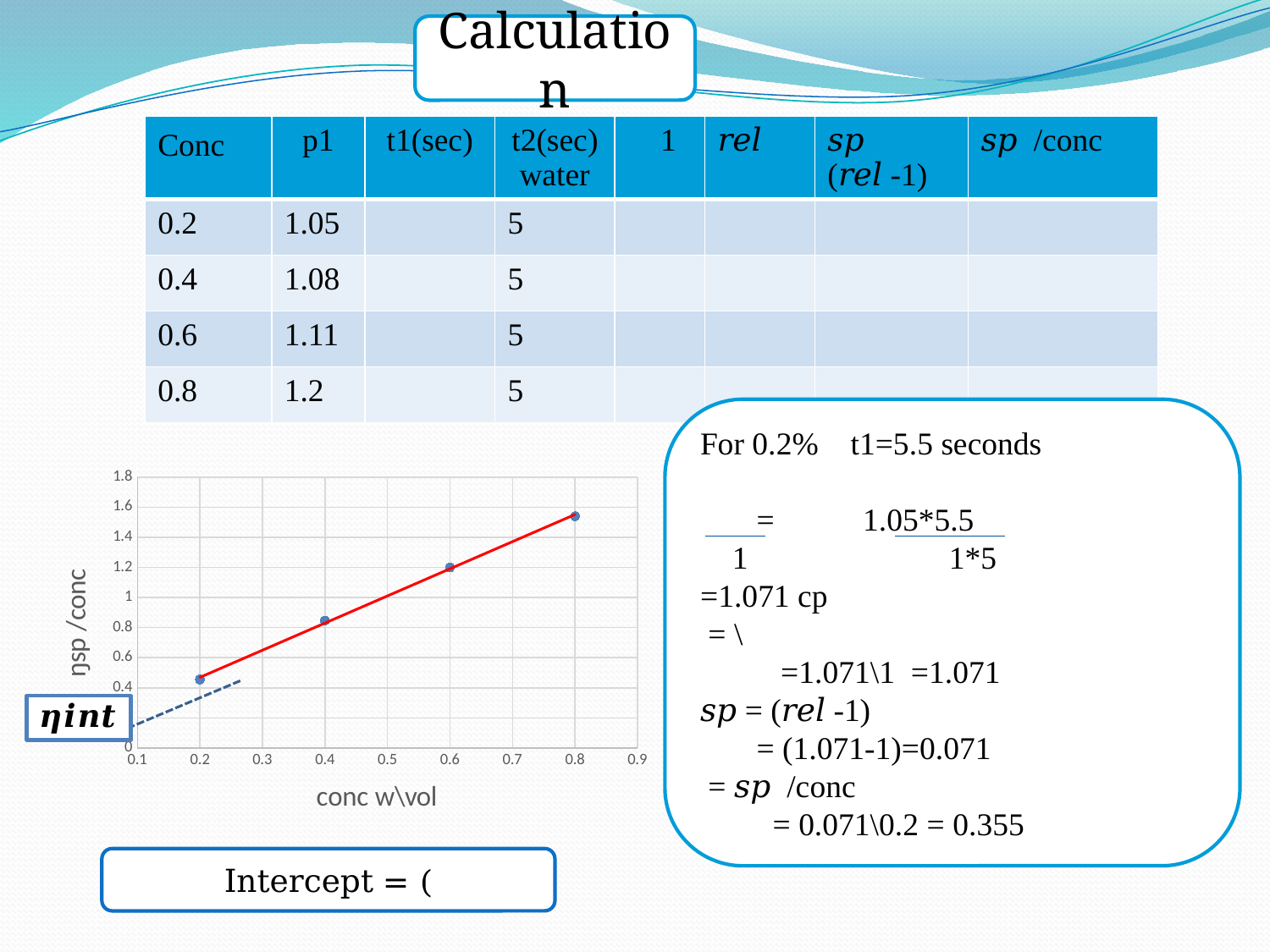
What is the title of the x axis of the chart? conc w\vol What is the title of the y axis of the chart? ŋsp /conc At which conc w\vol value is ŋsp/conc lowest? 0.2 What kind of chart is shown on the slide? scatter chart Do the plotted values rise or fall as conc w\vol increases along the x axis? rise Is the ŋsp/conc value at conc 0.6 greater or less than 1.4? less At which conc w\vol value is ŋsp/conc highest? 0.8 Is the ŋsp/conc value at conc 0.8 greater or less than 1.4? greater How many data points are plotted on the chart? 4 Is the ŋsp/conc value at conc 0.2 greater or less than 0.4? greater Which has the larger ŋsp/conc value: conc 0.4 or conc 0.6? 0.6